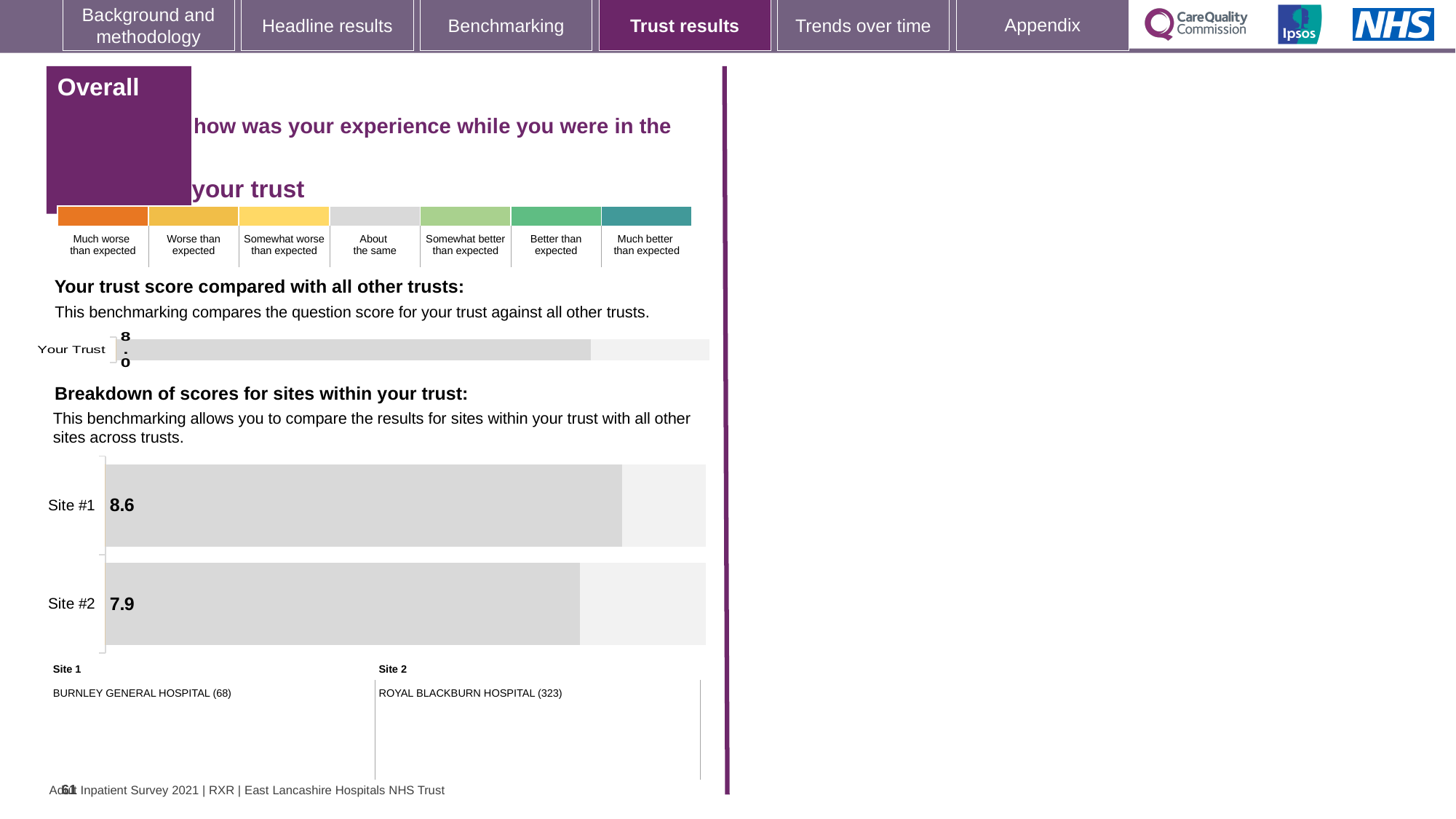
In the 'Your trust score compared with all other trusts' chart, what is the score for Your Trust? 8.0 According to the site key below the chart, which hospital is Site 1? BURNLEY GENERAL HOSPITAL (68) In the 'Breakdown of scores for sites within your trust' chart, which site has the lowest score? Site #2 In the 'Breakdown of scores for sites within your trust' chart, which site has the highest score? Site #1 How many bars are shown in the 'Your trust score compared with all other trusts' chart? 1 In the 'Breakdown of scores for sites within your trust' chart, which has the larger score, Site #1 or Site #2? Site #1 How many sites are shown in the 'Breakdown of scores for sites within your trust' chart? 2 In the 'Breakdown of scores for sites within your trust' chart, what is the score for Site #1? 8.6 In the 'Breakdown of scores for sites within your trust' chart, what is the difference between the scores of Site #1 and Site #2? 0.7 What kind of chart is the 'Breakdown of scores for sites within your trust' chart? Bar chart In the 'Breakdown of scores for sites within your trust' chart, what is the score for Site #2? 7.9 According to the site key below the chart, which hospital is Site 2? ROYAL BLACKBURN HOSPITAL (323)